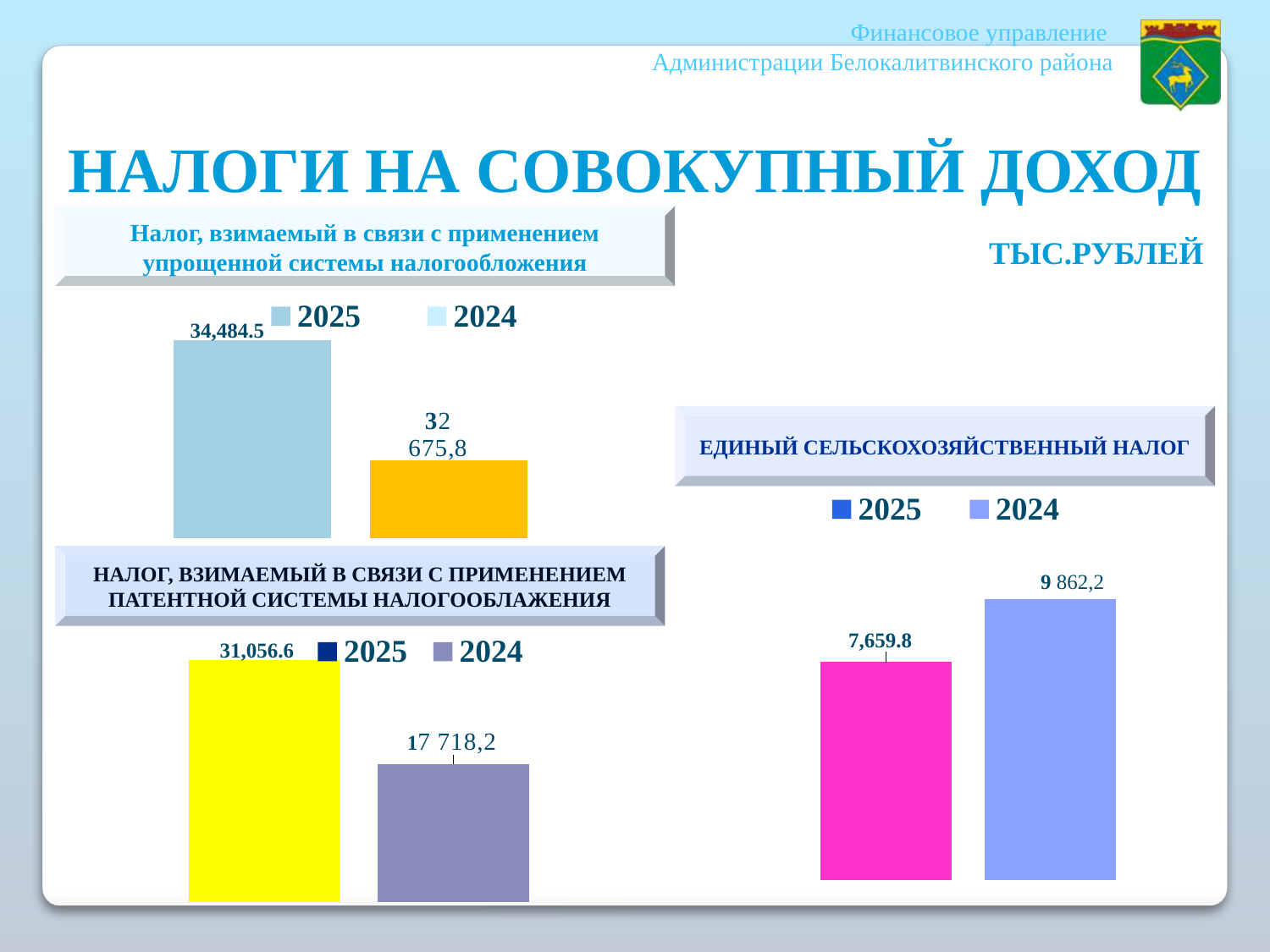
In the chart titled 'Единый сельскохозяйственный налог', what is the value for 2025? 7,659.8 In the chart titled 'Налог, взимаемый в связи с применением патентной системы налогооблажения', what is the difference between the 2025 and 2024 values? 13,338.4 In the chart titled 'Налог, взимаемый в связи с применением упрощенной системы налогообложения', what is the value for 2025? 34,484.5 In the chart titled 'Налог, взимаемый в связи с применением патентной системы налогооблажения', what is the value for 2024? 17 718,2 In the chart titled 'Налог, взимаемый в связи с применением упрощенной системы налогообложения', which year has the higher value? 2025 In the chart titled 'Единый сельскохозяйственный налог', what is the value for 2024? 9 862,2 In the chart titled 'Налог, взимаемый в связи с применением патентной системы налогооблажения', what is the value for 2025? 31,056.6 In the chart titled 'Налог, взимаемый в связи с применением патентной системы налогооблажения', which year has the lower value? 2024 In the chart titled 'Налог, взимаемый в связи с применением упрощенной системы налогообложения', what is the value for 2024? 32 675,8 How many series does the legend list in the chart titled 'Единый сельскохозяйственный налог'? 2 What kind of chart is the chart titled 'Единый сельскохозяйственный налог'? bar chart In the chart titled 'Единый сельскохозяйственный налог', which year has the higher value? 2024